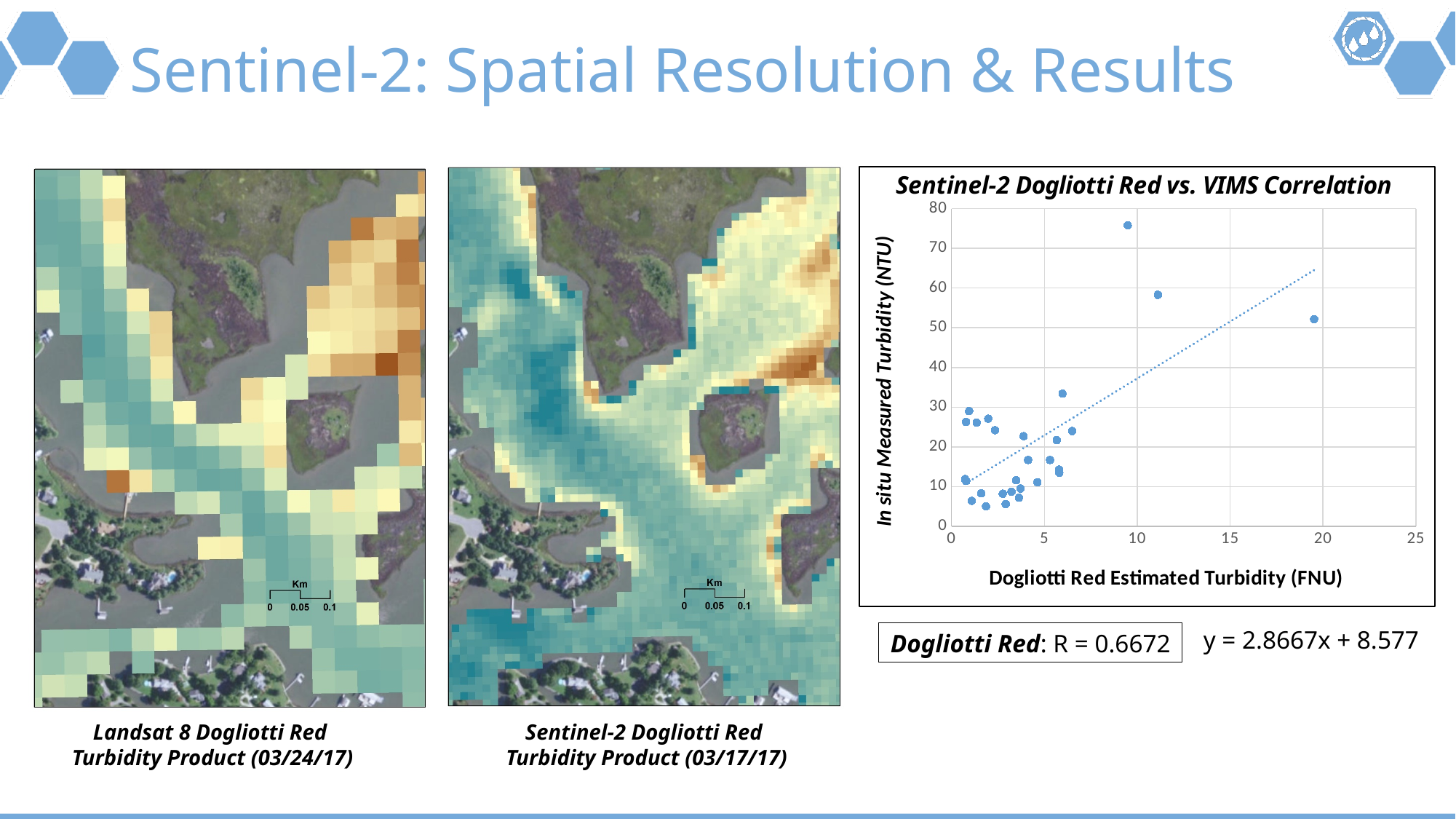
Is the in situ measured turbidity of the point near 11 FNU greater or less than 50? greater What is the title of the chart on the slide? Sentinel-2 Dogliotti Red vs. VIMS Correlation Is the highest in situ measured turbidity value plotted on the chart greater or less than 70? greater What correlation coefficient R is reported for Dogliotti Red on the slide? R = 0.6672 Do the in situ measured turbidity values generally rise or fall as Dogliotti Red estimated turbidity increases along the x axis? Rise What kind of chart is shown on the slide? Scatter plot What is the equation of the trend line given on the slide? y = 2.8667x + 8.577 Is the largest Dogliotti Red estimated turbidity value plotted on the chart greater or less than 15? greater What is the maximum value shown on the y axis of the chart? 80 What is the label of the x axis of the chart? Dogliotti Red Estimated Turbidity (FNU)